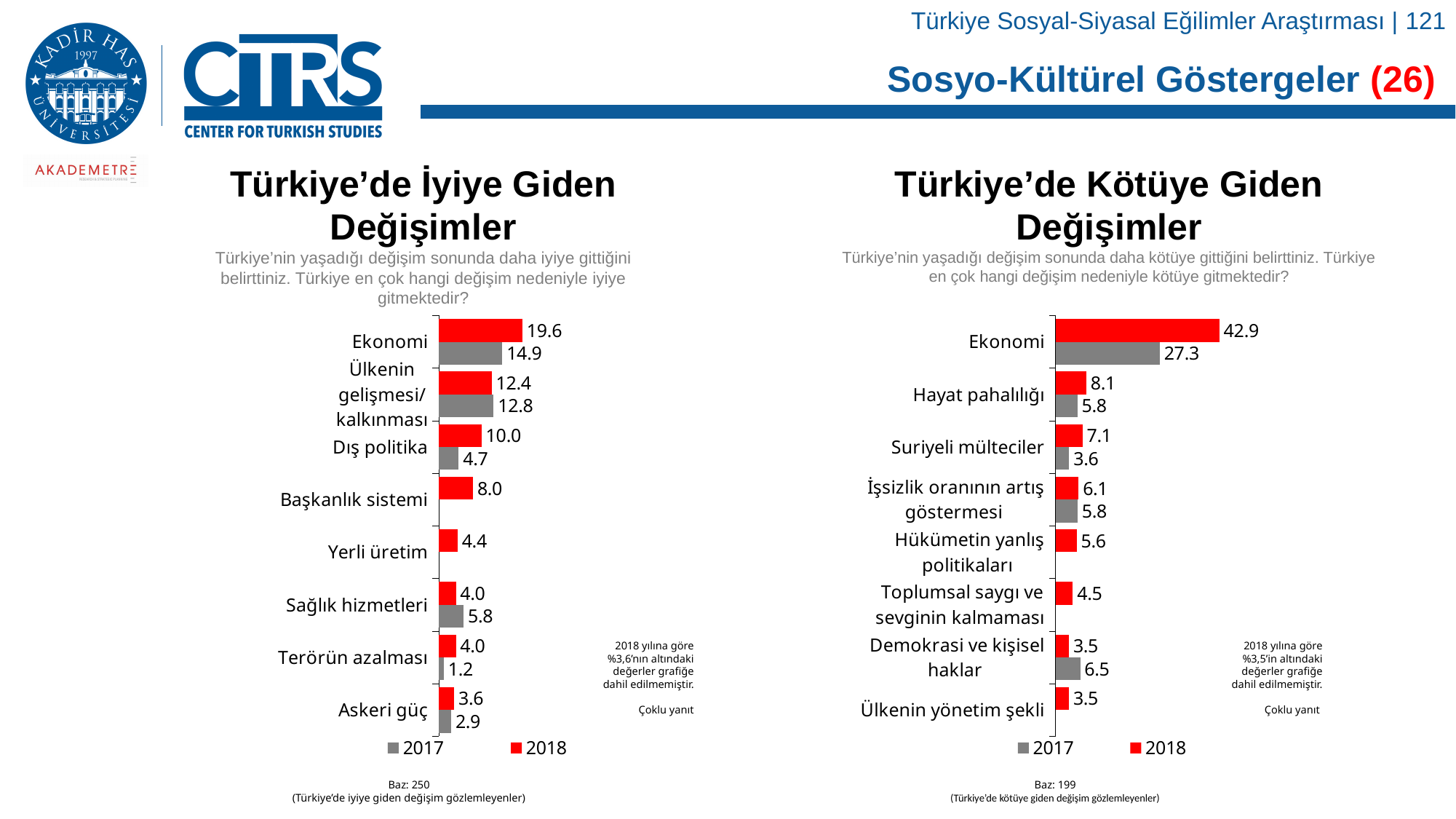
How many categories are shown in the 'Türkiye'de Kötüye Giden Değişimler' chart? 8 In the 'Türkiye'de İyiye Giden Değişimler' chart, which category has the lowest 2017 value shown? Terörün azalması In the 'Türkiye'de Kötüye Giden Değişimler' chart, which category has the highest 2018 value? Ekonomi In the 'Türkiye'de İyiye Giden Değişimler' chart, which is larger for Sağlık hizmetleri: the 2017 value or the 2018 value? 2017 In the 'Türkiye'de İyiye Giden Değişimler' chart, what is the 2017 value for Dış politika? 4.7 In the 'Türkiye'de Kötüye Giden Değişimler' chart, what is the 2018 value for Suriyeli mülteciler? 7.1 What type of chart is the 'Türkiye'de Kötüye Giden Değişimler' chart? Bar chart In the 'Türkiye'de İyiye Giden Değişimler' chart, what is the 2018 value for Ekonomi? 19.6 In the 'Türkiye'de Kötüye Giden Değişimler' chart, what is the difference between the 2018 and 2017 values for Ekonomi? 15.6 How many series does the legend of the 'Türkiye'de İyiye Giden Değişimler' chart list? 2 In the 'Türkiye'de İyiye Giden Değişimler' chart, what is the difference between the 2018 and 2017 values for Dış politika? 5.3 In the 'Türkiye'de Kötüye Giden Değişimler' chart, what is the 2017 value for Demokrasi ve kişisel haklar? 6.5